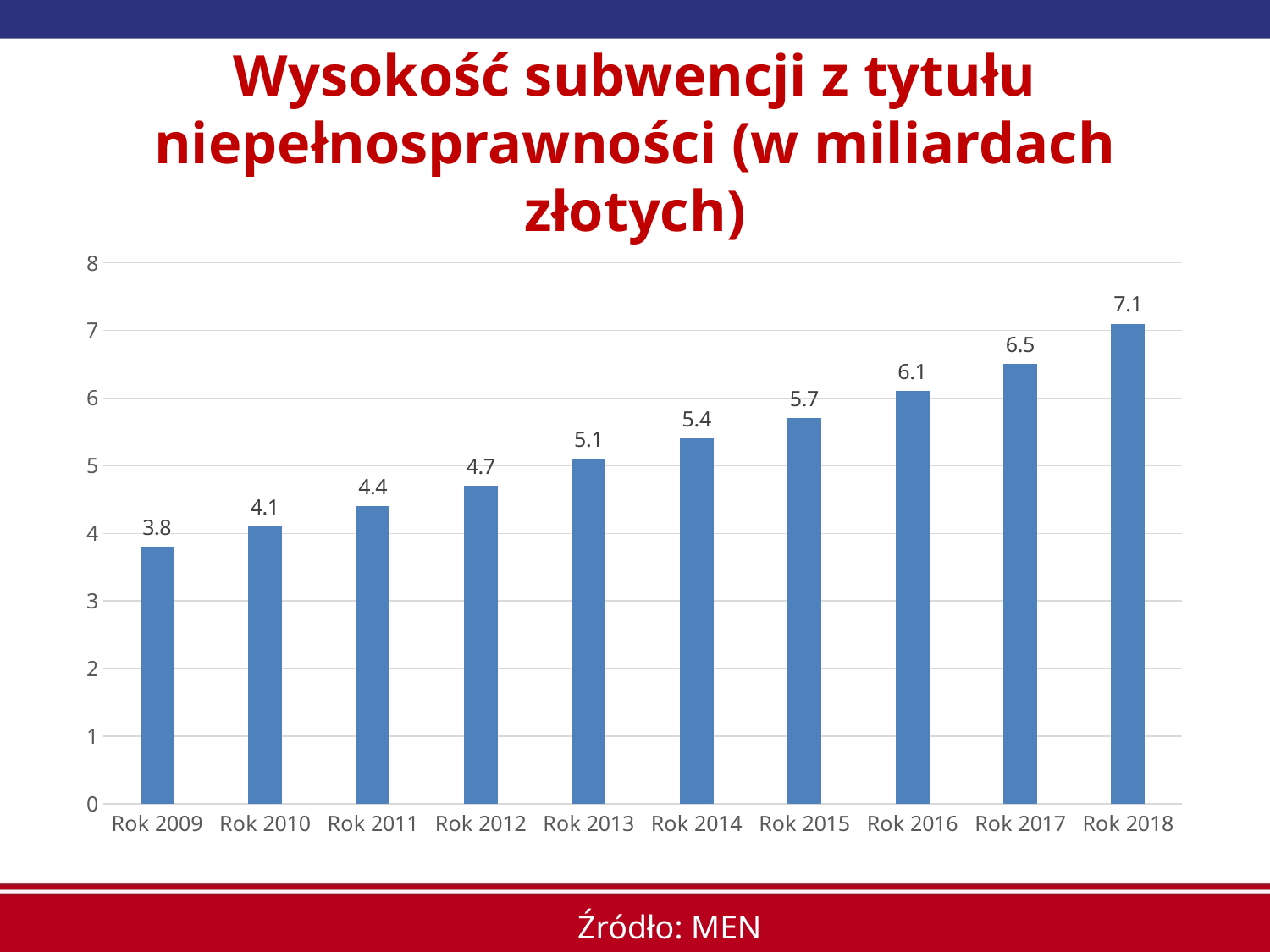
What is the value for Rok 2009? 3.8 Which year has the lowest value? Rok 2009 What is the value for Rok 2016? 6.1 What is the difference between the values for Rok 2015 and Rok 2014? 0.3 What kind of chart is shown on the slide? bar chart Which is larger, the value for Rok 2011 or the value for Rok 2012? Rok 2012 Is the value for Rok 2017 greater or less than 6? greater Which year has the highest value? Rok 2018 What is the value for Rok 2013? 5.1 How many years are shown on the x axis? 10 What is the difference between the values for Rok 2018 and Rok 2009? 3.3 Do the values rise or fall from Rok 2009 to Rok 2018? rise